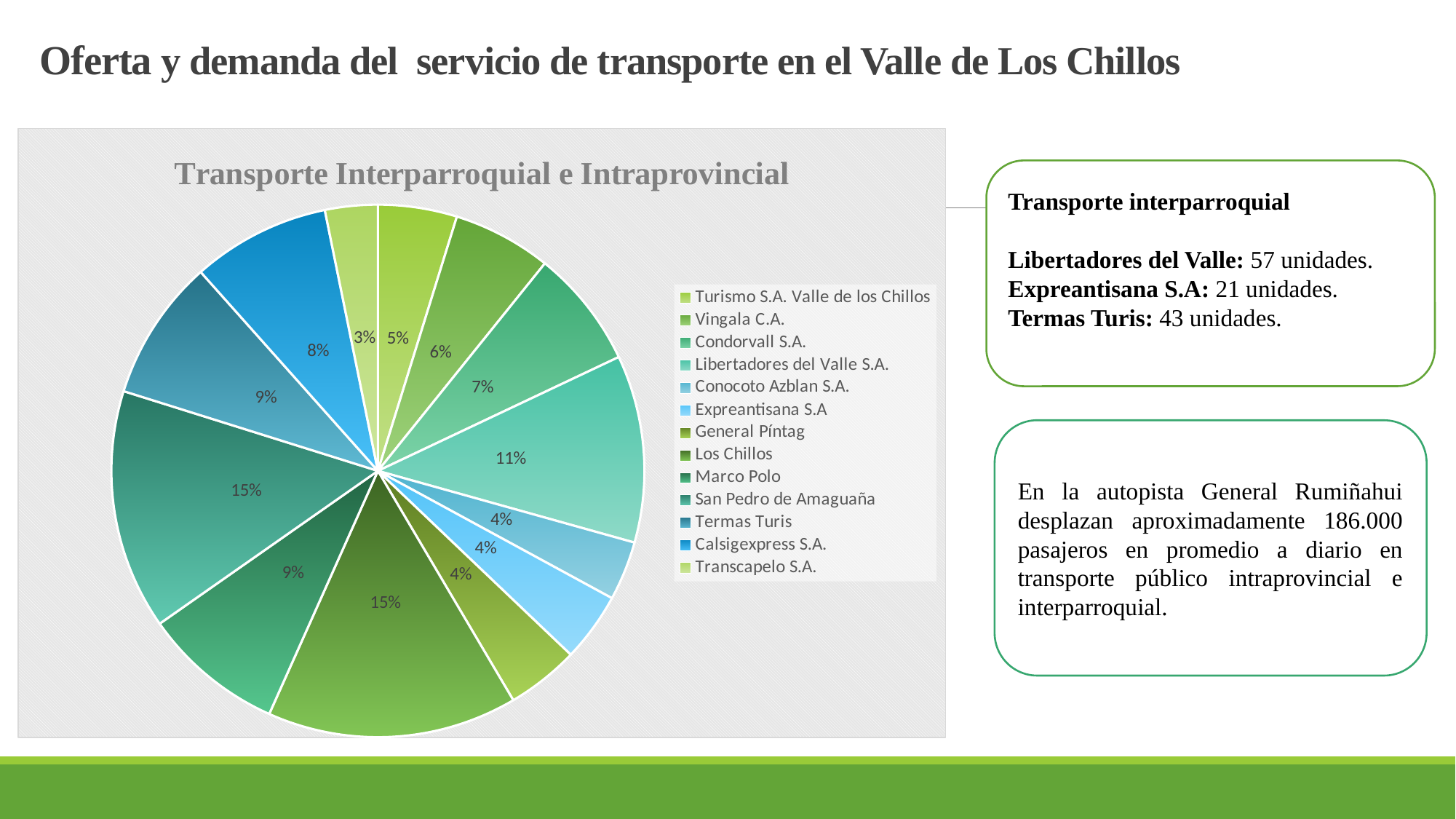
What percentage is shown for Condorvall S.A.? 7% What share of the pie does Libertadores del Valle S.A. have? 11% Which category has the smallest slice of the pie? Transcapelo S.A. What percentage is shown for Los Chillos? 15% What percentage is shown for Expreantisana S.A? 4% How many categories does the pie chart's legend list? 13 What is the difference in percentage points between San Pedro de Amaguaña and Marco Polo? 6 What percentage is shown for Calsigexpress S.A.? 8% What kind of chart is shown on the slide? pie chart What percentage is shown for Transcapelo S.A.? 3% What is the title of the chart? Transporte Interparroquial e Intraprovincial Which is larger, the slice for Termas Turis or the slice for Vingala C.A.? Termas Turis